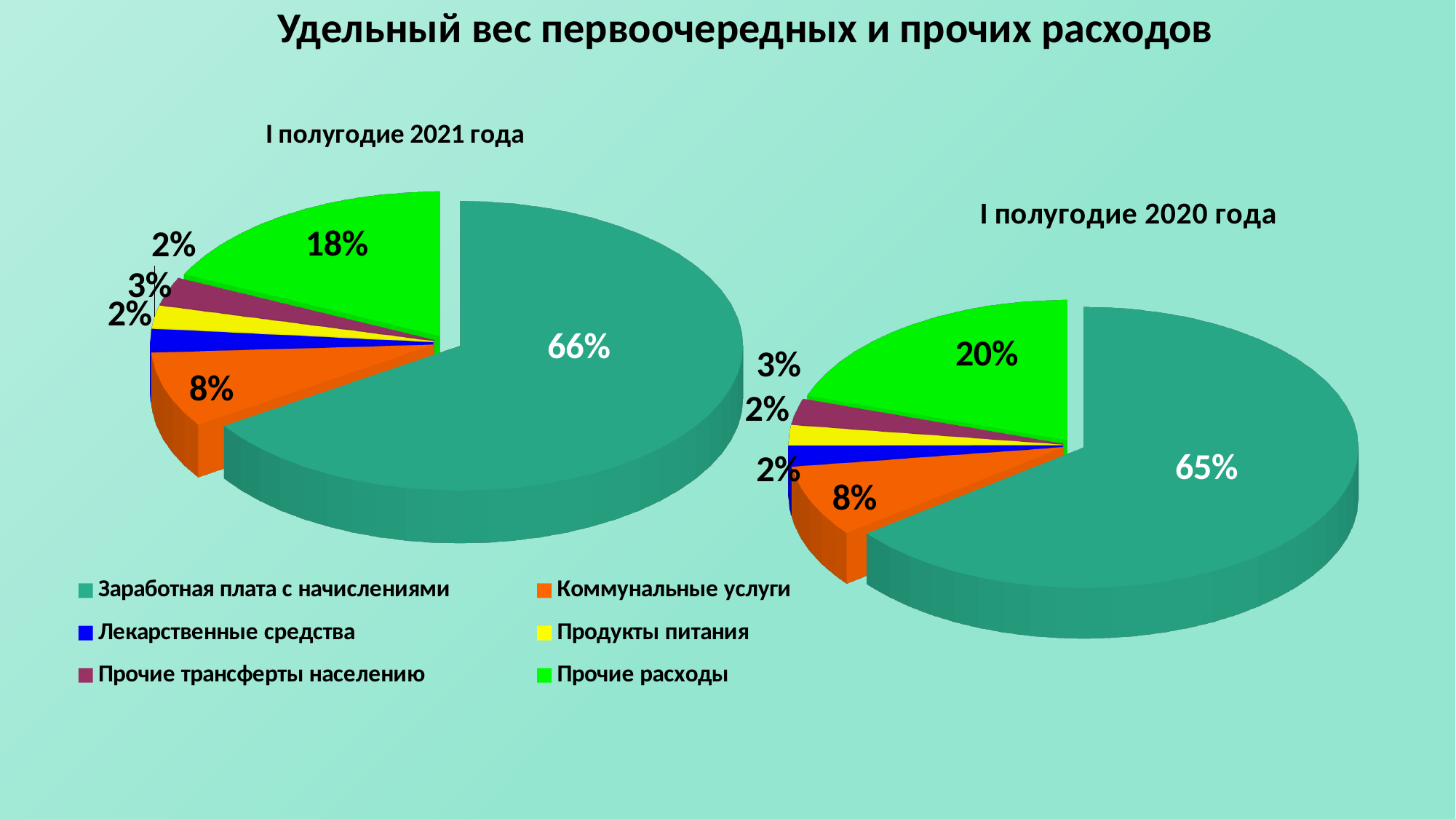
In the 'I полугодие 2020 года' chart, which category has the largest share? Заработная плата с начислениями In the 'I полугодие 2021 года' chart, which category has the largest share? Заработная плата с начислениями How many categories does the legend list for the charts? 6 In the 'I полугодие 2021 года' chart, what is the difference in percentage points between Заработная плата с начислениями and Прочие расходы? 48 In the 'I полугодие 2021 года' chart, what share is shown for Заработная плата с начислениями? 66% What type of chart is used for 'I полугодие 2021 года'? Pie chart What is the title of the slide above the two charts? Удельный вес первоочередных и прочих расходов In the 'I полугодие 2021 года' chart, what share is shown for Прочие расходы? 18% Is the share of Прочие расходы larger in the 'I полугодие 2021 года' chart or the 'I полугодие 2020 года' chart? I полугодие 2020 года In the 'I полугодие 2020 года' chart, what share is shown for Прочие расходы? 20% In the 'I полугодие 2020 года' chart, what share is shown for Коммунальные услуги? 8% In the 'I полугодие 2020 года' chart, what share is shown for Заработная плата с начислениями? 65%